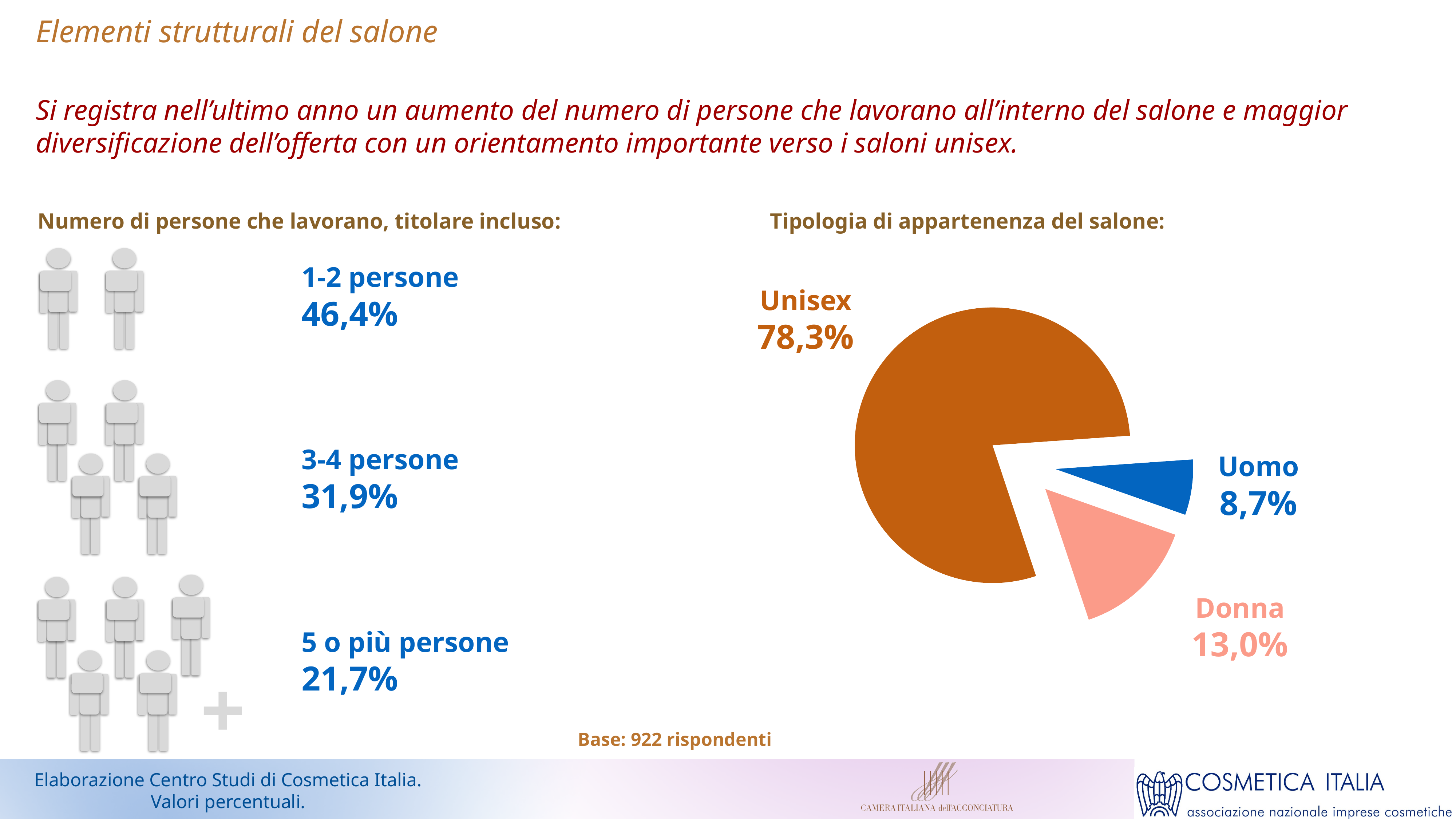
How many slices does the pie chart 'Tipologia di appartenenza del salone' have? 3 In the pie chart 'Tipologia di appartenenza del salone', what is the difference in percentage points between Donna and Uomo? 4,3 In the pie chart 'Tipologia di appartenenza del salone', what is the value for Uomo? 8,7% What kind of chart is shown under 'Tipologia di appartenenza del salone'? pie chart In the pie chart 'Tipologia di appartenenza del salone', what is the value for Unisex? 78,3% In the pie chart 'Tipologia di appartenenza del salone', which is larger, Donna or Uomo? Donna In the left infographic 'Numero di persone che lavorano, titolare incluso', which category has the highest value? 1-2 persone In the pie chart 'Tipologia di appartenenza del salone', which category has the largest slice? Unisex In the left infographic 'Numero di persone che lavorano, titolare incluso', what is the value for '3-4 persone'? 31,9% In the pie chart 'Tipologia di appartenenza del salone', which category has the smallest slice? Uomo In the pie chart 'Tipologia di appartenenza del salone', what is the value for Donna? 13,0% In the pie chart 'Tipologia di appartenenza del salone', what colour is the Unisex slice? orange